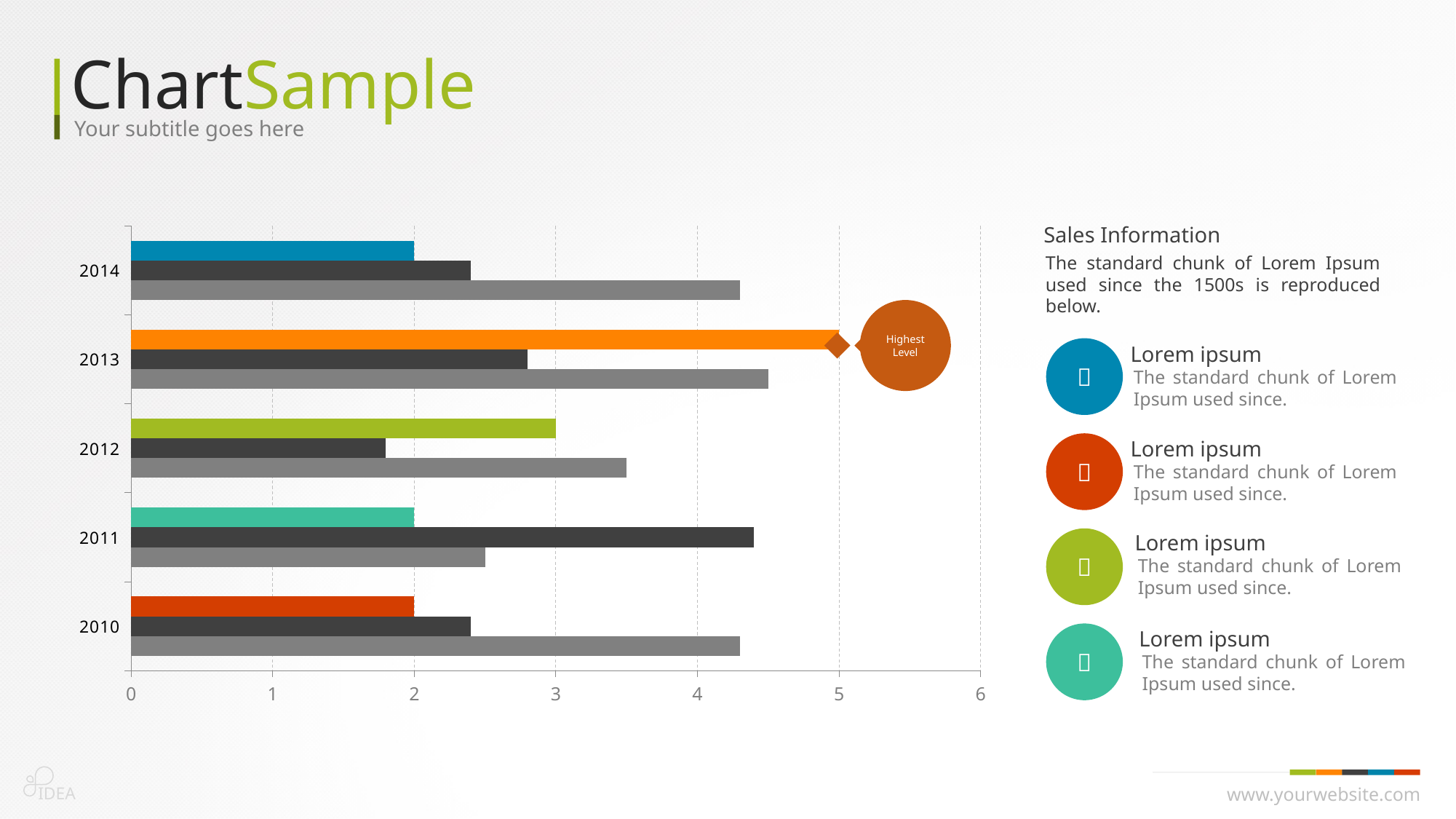
Is the value of the dark gray bar for 2011 greater or less than 4? greater Which year has the longest top coloured bar? 2013 Which year has the shortest light gray bar? 2011 How many bars are plotted for each year in the chart? 3 What text appears in the circular callout attached to the 2013 bar? Highest Level What is the value of the top (green) bar for 2012? 3 Is the value of the dark gray bar for 2012 greater or less than 2? less Which is larger: the light gray bar for 2013 or the light gray bar for 2012? 2013 How many years are shown on the vertical axis of the chart? 5 What is the value of the top (orange) bar for 2013? 5 What kind of chart is shown on the slide? bar chart What is the value of the top (blue) bar for 2014? 2